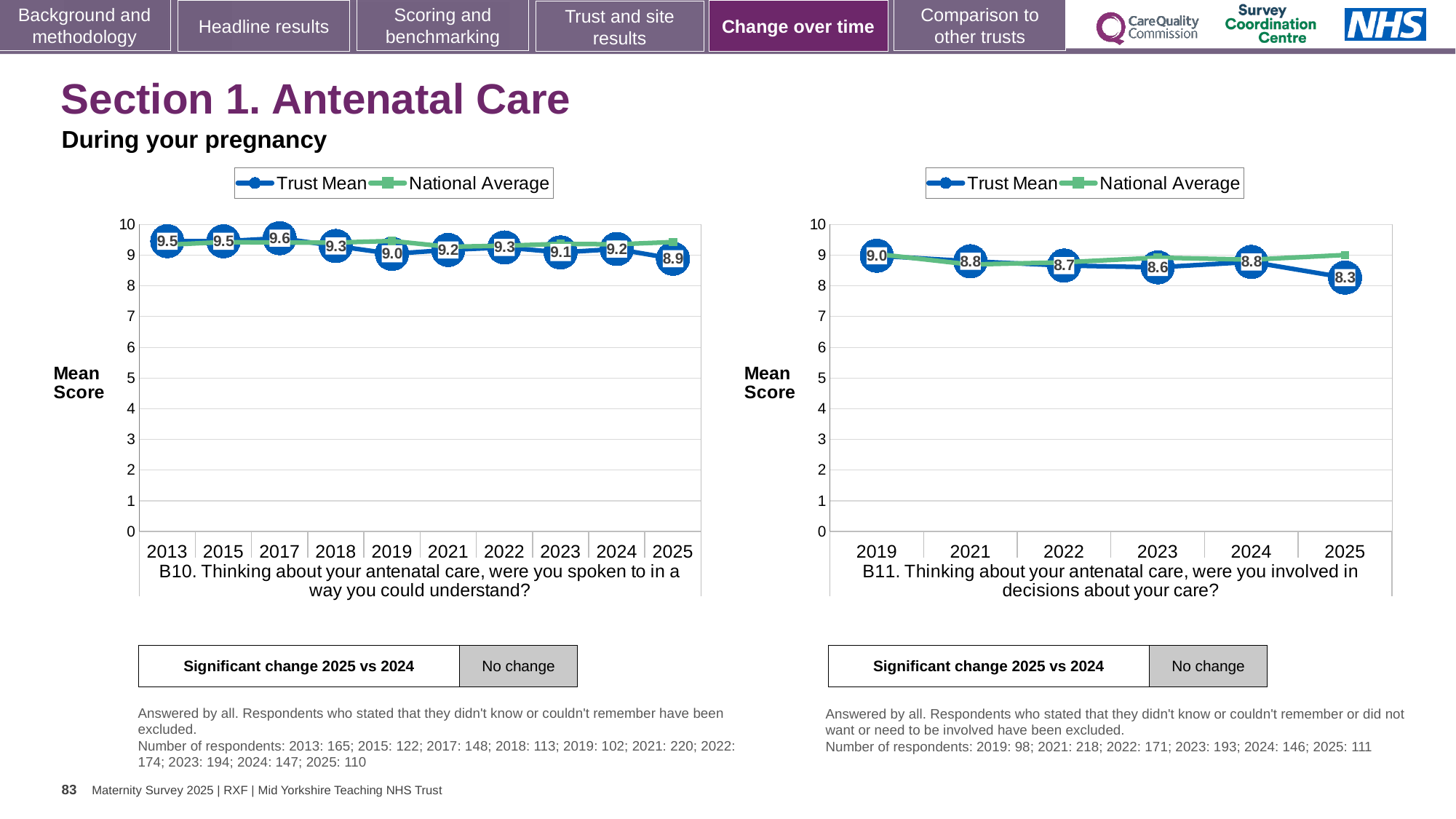
In the B10 chart on the left, which year has the highest Trust Mean score? 2017 How many series does the legend of the B11 chart on the right list? 2 In the B11 chart on the right, what is the difference between the Trust Mean scores for 2024 and 2025? 0.5 In the B11 chart on the right, is the National Average value for 2025 greater or less than 8? greater In the B10 chart on the left, what is the difference between the Trust Mean scores for 2017 and 2025? 0.7 In the B11 chart on the right, what is the Trust Mean score for 2025? 8.3 How many years are shown on the x axis of the B10 chart on the left? 10 In the B10 chart on the left, which year has the lowest Trust Mean score? 2025 In the B11 chart on the right, which year has the highest Trust Mean score? 2019 In the B11 chart on the right, is the Trust Mean score for 2022 larger or smaller than the score for 2025? larger In the B10 chart on the left, what is the Trust Mean score for 2017? 9.6 In the B10 chart on the left, what is the Trust Mean score for 2025? 8.9